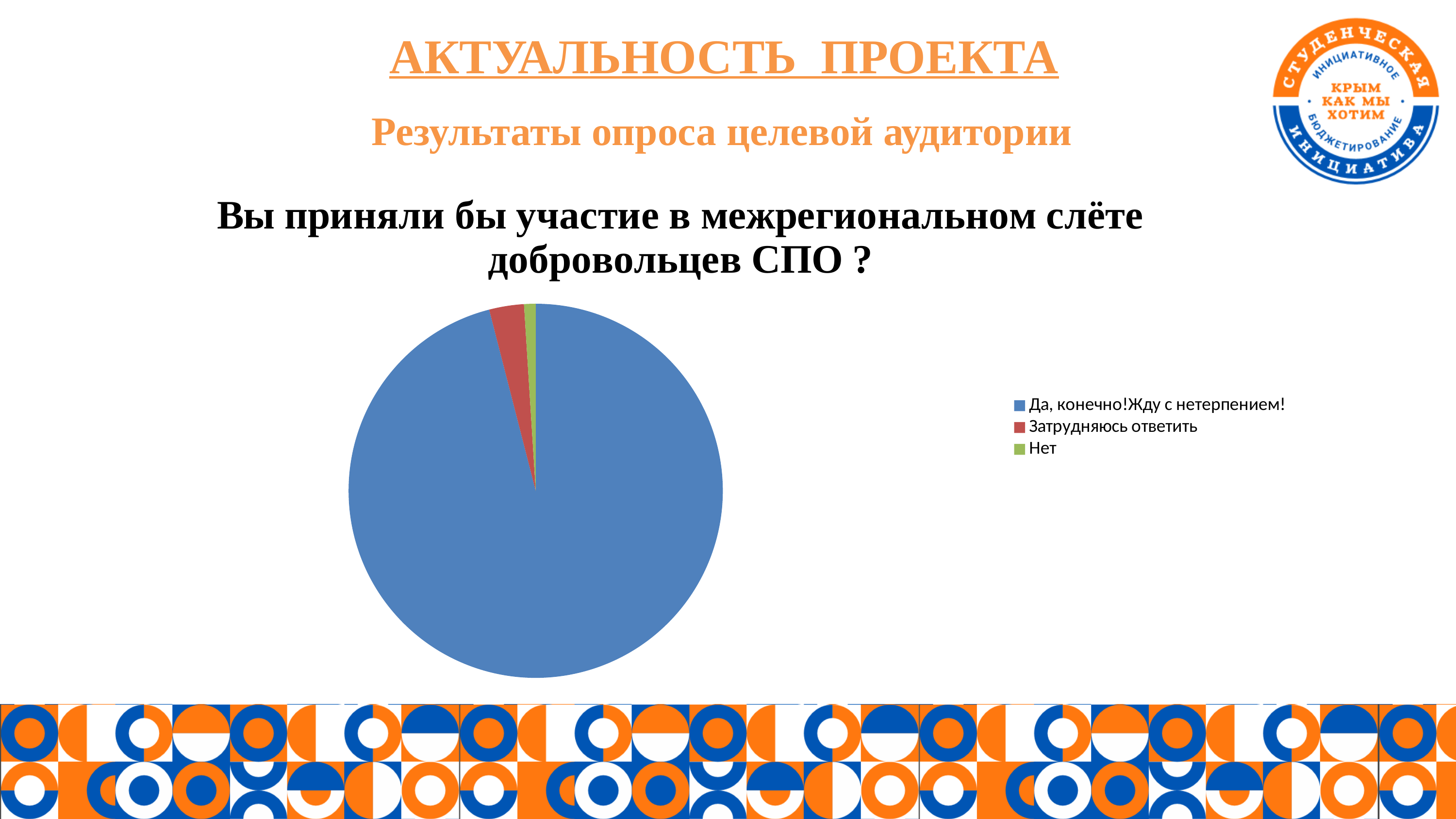
Which answer option has the largest slice in the pie chart? Да, конечно!Жду с нетерпением! What question is the pie chart reporting the survey results for? Вы приняли бы участие в межрегиональном слёте добровольцев СПО ? Which slice is larger: "Затрудняюсь ответить" or "Нет"? Затрудняюсь ответить How many slices does the pie chart have? 3 Which slice is larger: "Да, конечно!Жду с нетерпением!" or "Затрудняюсь ответить"? Да, конечно!Жду с нетерпением! How many entries does the legend of the pie chart list? 3 What colour is the slice for "Нет" in the pie chart? Green What kind of chart is shown on the slide? Pie chart Which answer option has the smallest slice in the pie chart? Нет